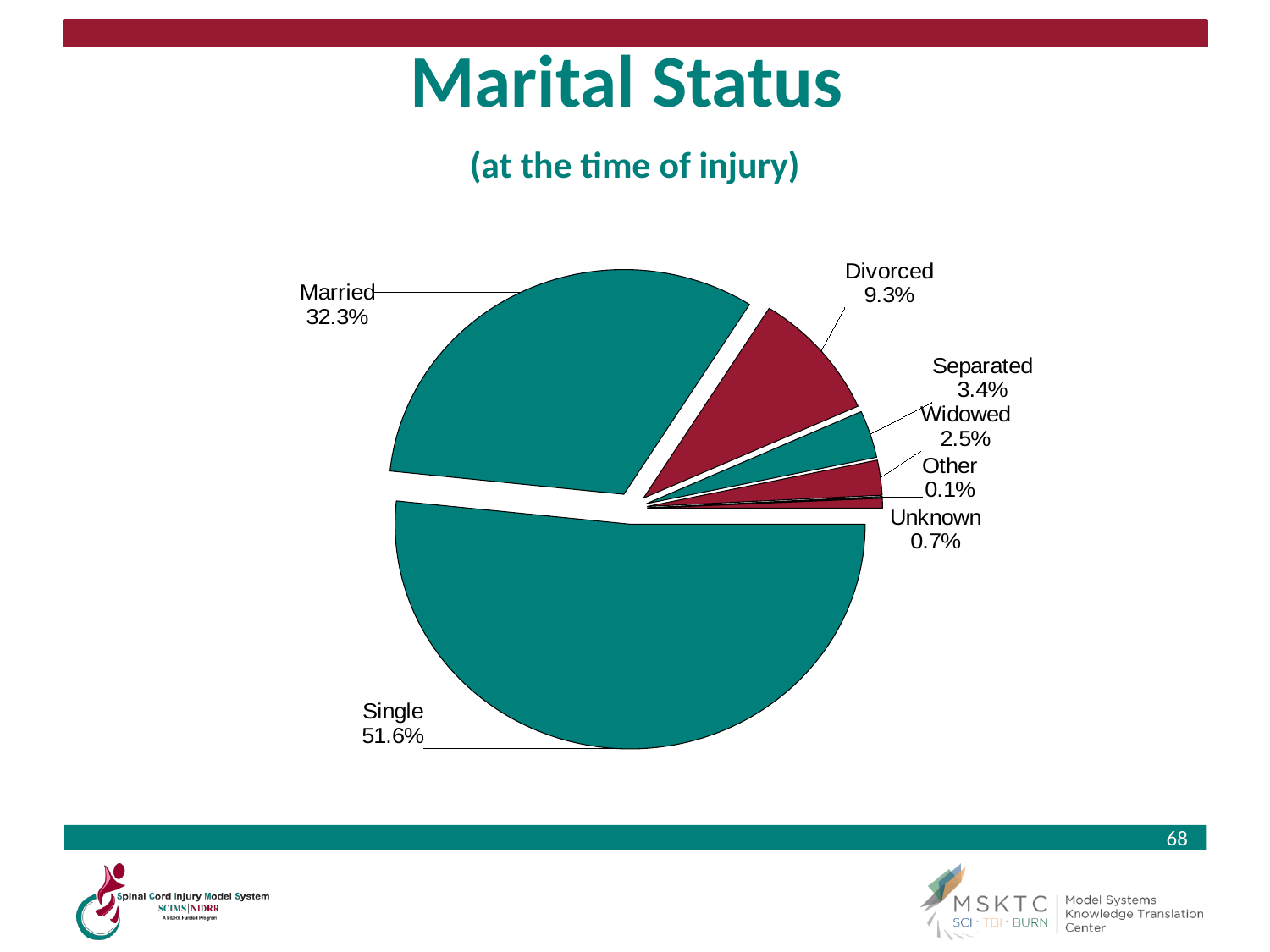
What percentage of the pie is labelled Divorced? 9.3% What percentage of the pie is labelled Married? 32.3% Which slice is larger, Separated or Widowed? Separated How many categories are shown in the pie chart? 7 What kind of chart is shown on the slide? pie chart Which marital status category has the largest slice? Single What is the difference in percentage points between the Divorced and Separated slices? 5.9 What is the subtitle shown under the chart title 'Marital Status'? (at the time of injury) What percentage of the pie is labelled Widowed? 2.5% What is the difference in percentage points between the Single and Married slices? 19.3 Which marital status category has the smallest slice? Other What percentage of the pie is labelled Single? 51.6%